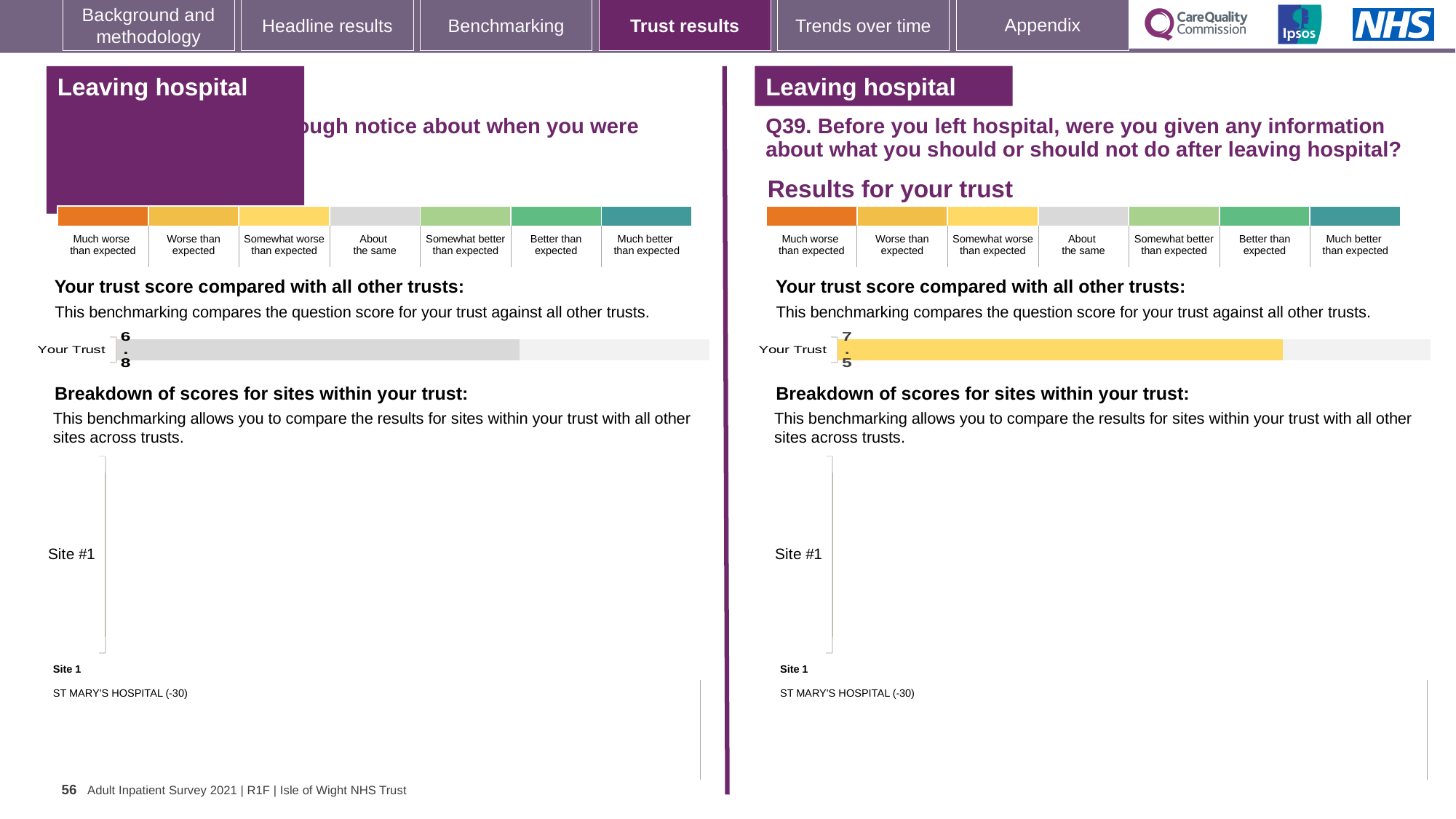
On the right-hand Q39 chart, which benchmark category does the colour of the Your Trust bar correspond to? Somewhat worse than expected On the left-hand chart, which benchmark category does the colour of the Your Trust bar correspond to? About the same On the right-hand chart for Q39, what is the score shown for Your Trust? 7.5 On the left-hand chart, what is the score shown for Your Trust? 6.8 How many benchmark categories are shown in the colour key above the right-hand Q39 chart? 7 What is the difference between the Your Trust score on the right-hand Q39 chart and the Your Trust score on the left-hand chart? 0.7 What kind of chart is used to show the Your Trust score on the right-hand Q39 chart? Bar chart How many bars are plotted in the 'Your trust score compared with all other trusts' chart on the right-hand side? 1 Which chart shows the higher Your Trust score, the left-hand chart or the right-hand Q39 chart? The right-hand Q39 chart How many sites are listed in the 'Breakdown of scores for sites within your trust' chart on the right-hand side? 1